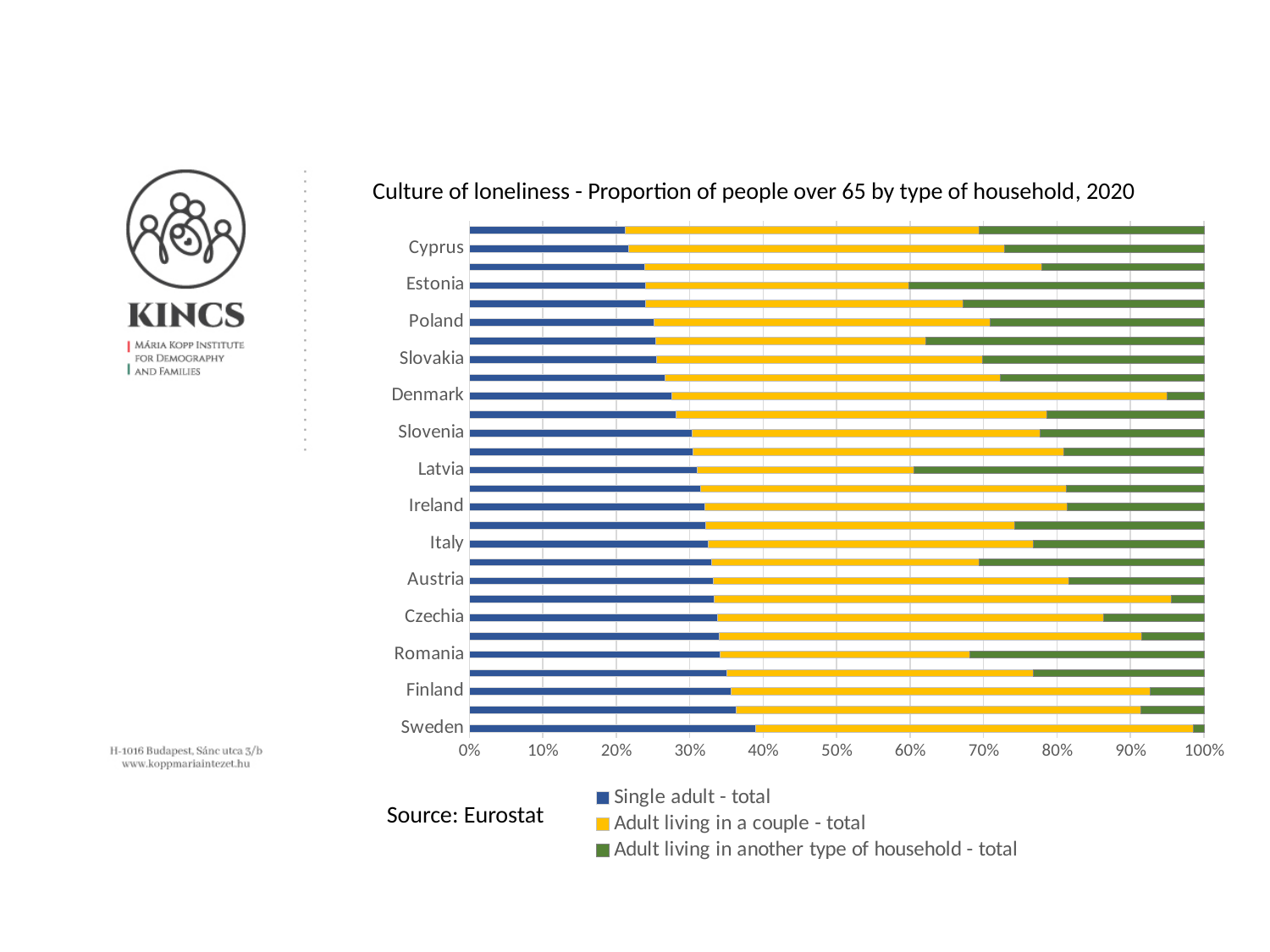
Is the 'Adult living in another type of household - total' share for Latvia greater or less than 30%? greater Which colour represents 'Single adult - total' in the chart? Blue Among the labelled countries, which has the largest 'Single adult - total' share? Sweden What is the title of the chart? Culture of loneliness - Proportion of people over 65 by type of household, 2020 Is the 'Single adult - total' share for Sweden greater or less than 30%? greater Is the 'Adult living in another type of household - total' share for Sweden greater or less than 10%? less Among the labelled countries, which has the smallest 'Single adult - total' share? Cyprus Which has the larger 'Adult living in another type of household - total' share, Denmark or Latvia? Latvia How many series does the legend list? 3 What kind of chart is shown on the slide? Stacked bar chart Does the 'Single adult - total' share increase or decrease going down the chart from Cyprus to Sweden? Increase